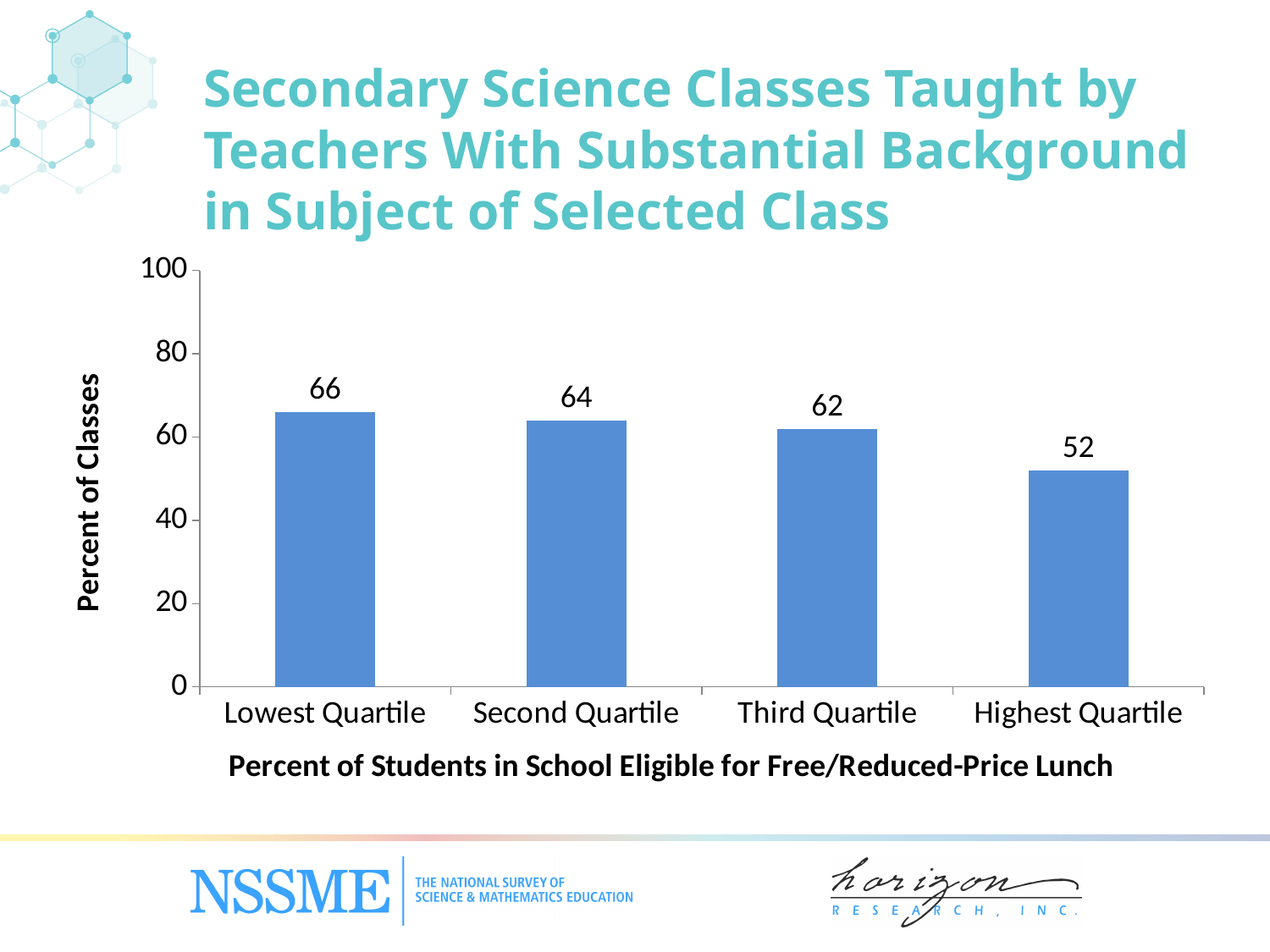
Do the values rise or fall from Lowest Quartile to Highest Quartile? fall What is the value for Second Quartile? 64 What kind of chart is shown on the slide? bar chart What is the value for Highest Quartile? 52 Which quartile has the highest percent of classes? Lowest Quartile Is the value for Highest Quartile greater or less than 60? less What is the value for Third Quartile? 62 What is the difference between the values for Lowest Quartile and Highest Quartile? 14 Which quartile has the lowest percent of classes? Highest Quartile Which is larger, the value for Second Quartile or the value for Highest Quartile? Second Quartile How many categories are shown on the x axis? 4 What is the value for Lowest Quartile? 66